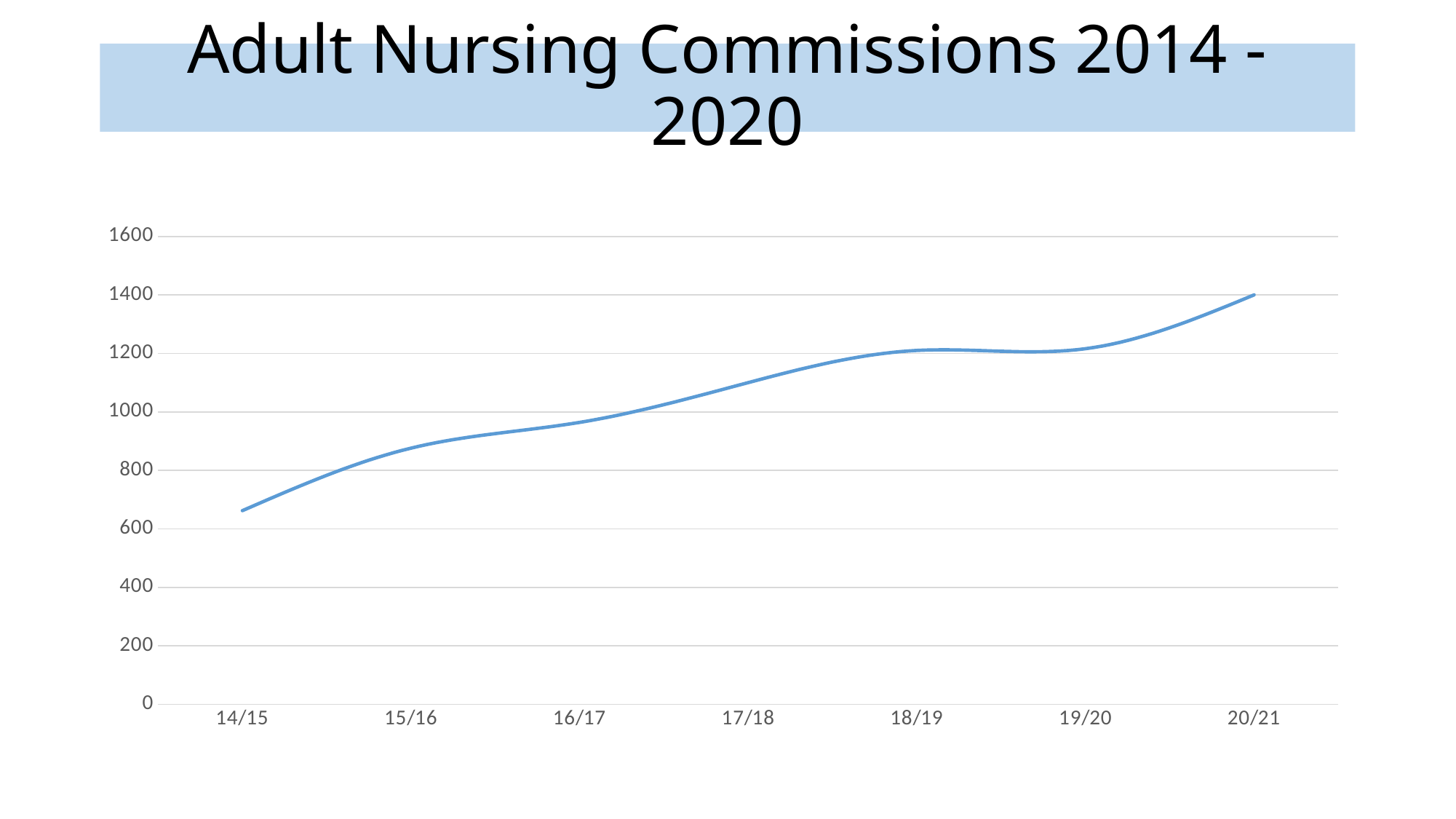
Is the value for 19/20 greater or less than 1400? less Which is larger, the value for 17/18 or the value for 15/16? 17/18 Which is larger, the value for 20/21 or the value for 18/19? 20/21 Do the values generally rise or fall from 14/15 to 20/21? rise Is the value for 15/16 greater or less than 800? greater What kind of chart is shown on the slide? line chart How many academic years are plotted along the x axis? 7 Which year has the lowest value? 14/15 Is the value for 14/15 greater or less than 800? less What is the title of the chart? Adult Nursing Commissions 2014 - 2020 Which year has the highest value? 20/21